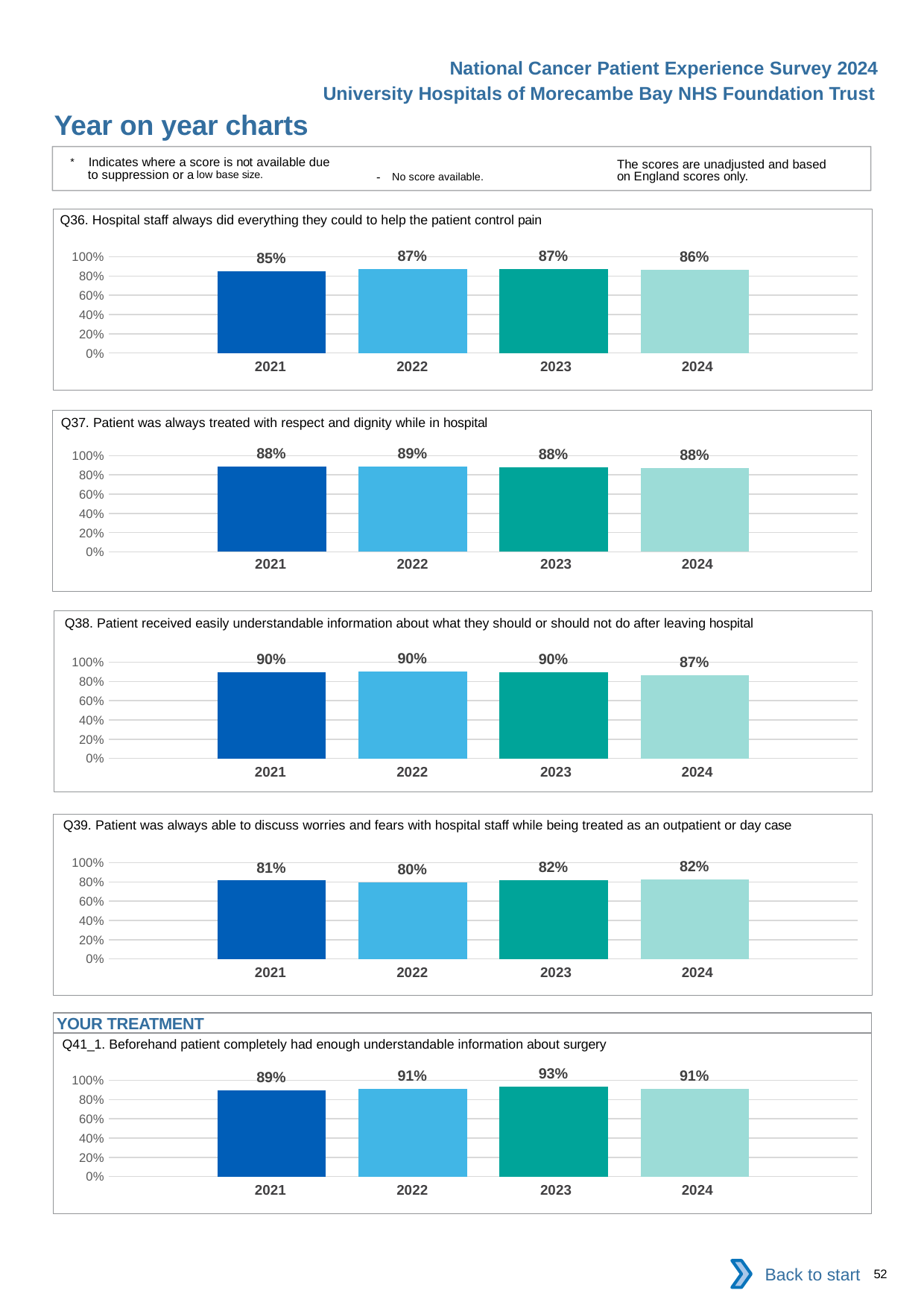
How many years are shown in the Q39 chart? 4 In the Q36 chart, is the value for 2022 larger than the value for 2021? Yes In the Q36 chart, what is the value for 2021? 85% In the Q41_1 chart, what is the value for 2022? 91% In the Q39 chart, which year has the lowest value? 2022 What type of chart is the Q37 chart? Bar chart In the Q38 chart, what is the value for 2024? 87% In the Q41_1 chart, what is the difference between the 2023 and 2021 values? 4% In the Q37 chart, which year has the highest value? 2022 In the Q41_1 chart, which year has the highest value? 2023 In the Q38 chart, what is the difference between the 2023 and 2024 values? 3% In the Q39 chart, is the value for 2024 greater or less than 60%? greater